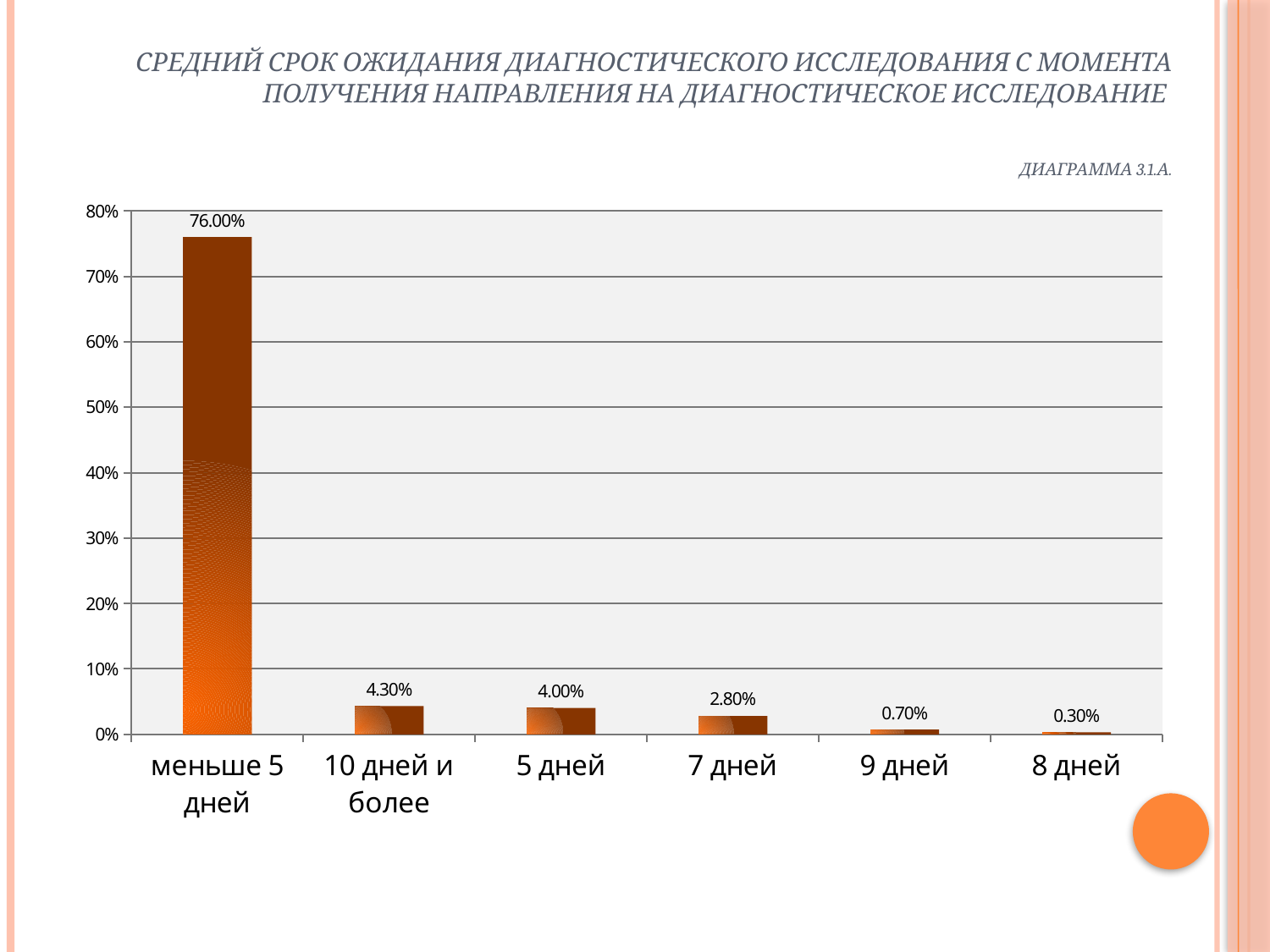
Is the value for "меньше 5 дней" greater or less than 70%? greater What is the value for "5 дней"? 4.00% Which category has the highest value? меньше 5 дней What is the value for "8 дней"? 0.30% What is the value for "7 дней"? 2.80% What kind of chart is shown on the slide? bar chart How many categories are shown on the x axis? 6 What is the difference between the values for "меньше 5 дней" and "10 дней и более"? 71.70% What is the value for "меньше 5 дней"? 76.00% Which category has the lowest value? 8 дней What is the value for "10 дней и более"? 4.30% Which is larger, the value for "7 дней" or the value for "9 дней"? 7 дней